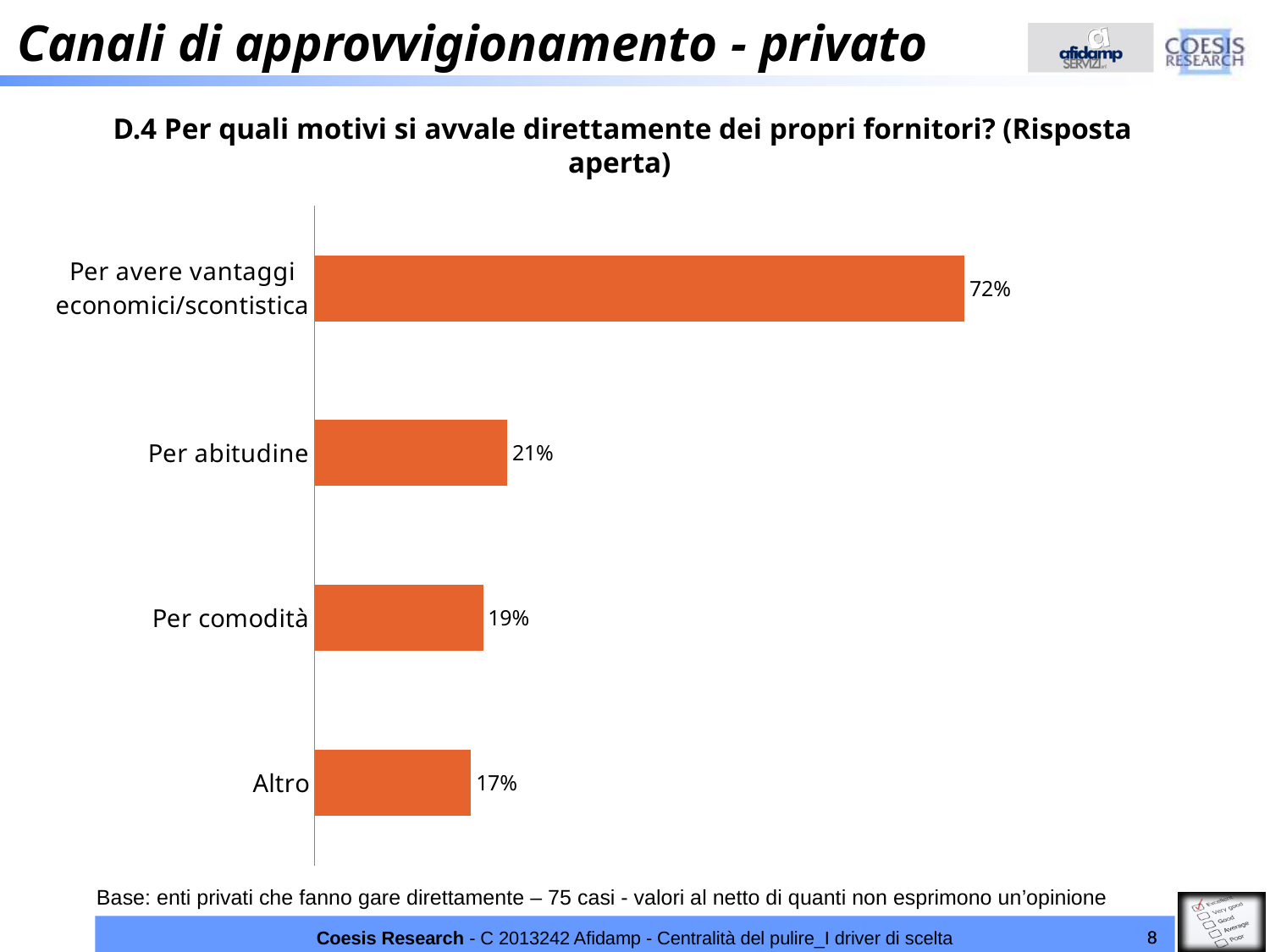
Which category has the lowest value? Altro What is the difference between the values for "Per avere vantaggi economici/scontistica" and "Per abitudine"? 51% Which category has the highest value? Per avere vantaggi economici/scontistica Which is larger, the value for "Per abitudine" or the value for "Altro"? Per abitudine What is the value for "Per comodità"? 19% What kind of chart is shown on the slide? Bar chart What is the value for "Per abitudine"? 21% How many categories are shown in the chart? 4 What is the title of the chart? D.4 Per quali motivi si avvale direttamente dei propri fornitori? (Risposta aperta) What is the difference between the values for "Per comodità" and "Altro"? 2% What is the value for "Altro"? 17% What is the value for "Per avere vantaggi economici/scontistica"? 72%